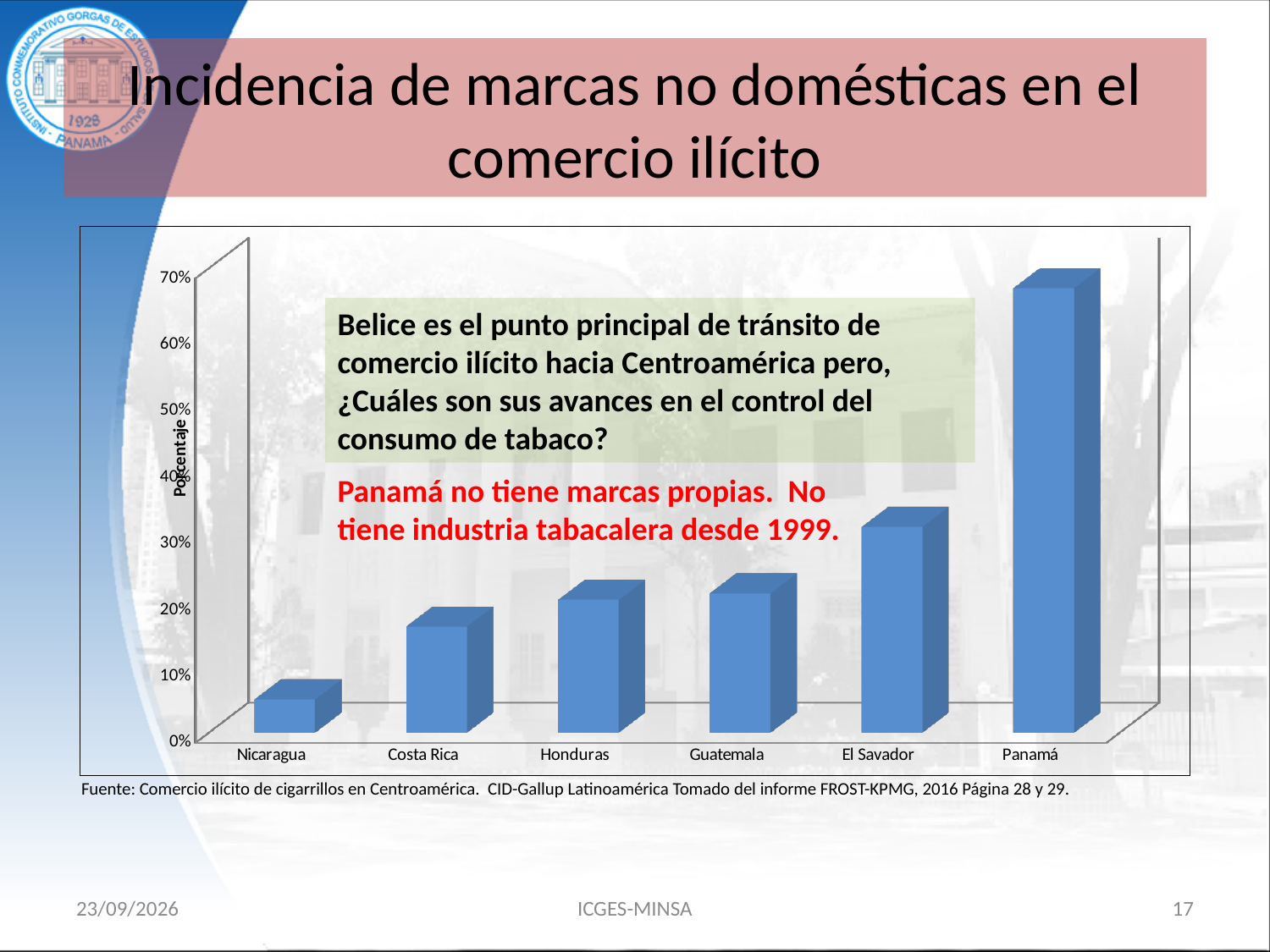
Is the value for Nicaragua greater or less than 10%? less What kind of chart is shown on the slide? bar chart Is the value for Honduras greater or less than 30%? less Is the value for Costa Rica greater or less than 20%? less Which country has the highest value in the chart? Panamá Which country has the lowest value in the chart? Nicaragua Which has a larger value, El Savador or Costa Rica? El Savador How many countries are shown on the x axis of the chart? 6 Do the values rise or fall moving from Nicaragua to Panamá along the x axis? rise